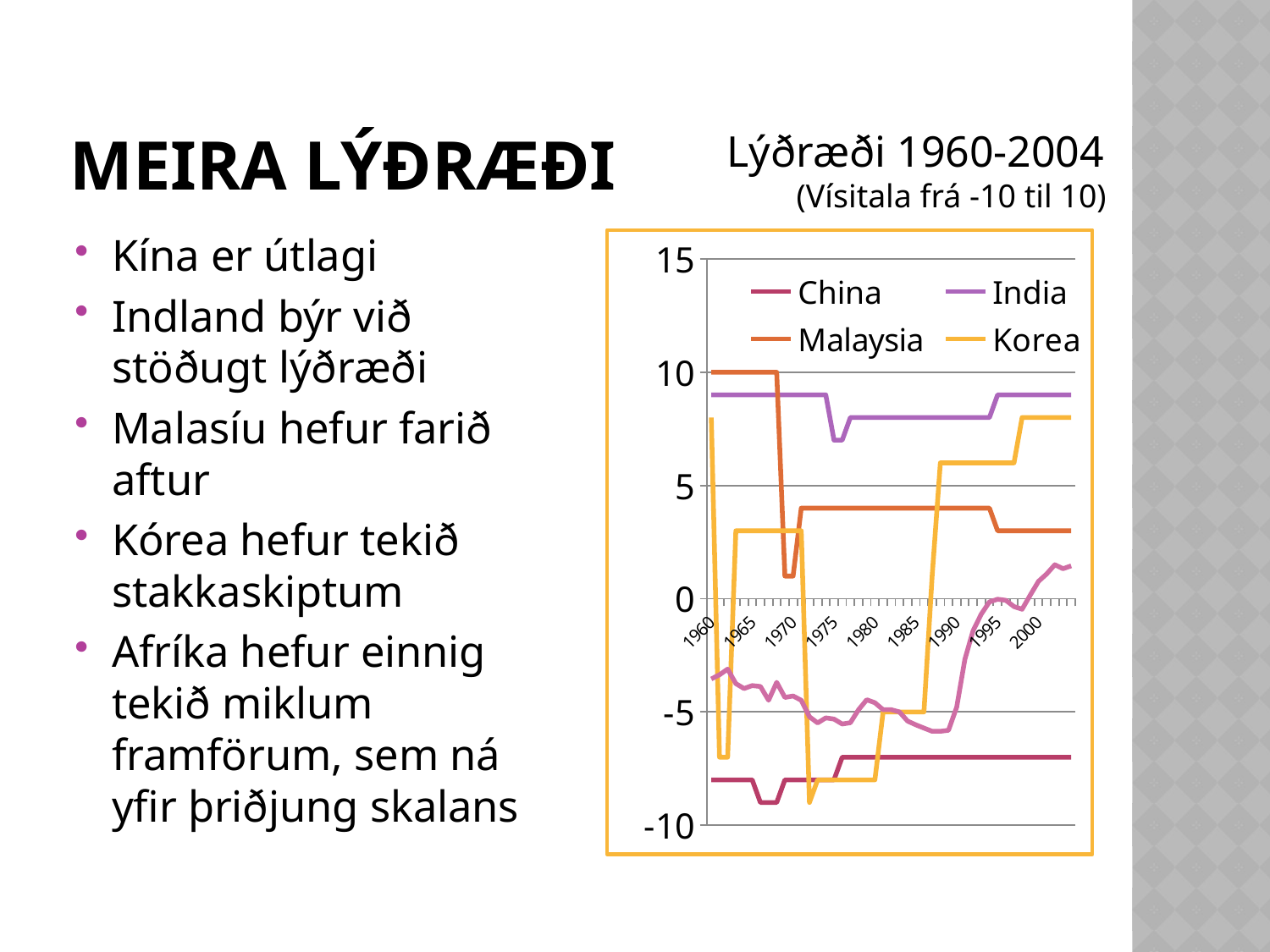
In 2000, which is higher, Korea or Malaysia? Korea What kind of chart is shown on the slide? line chart Which series has the lowest value in 2000? China Is the value for Malaysia in 2000 greater or less than 5? less Which series has the highest value in 1960? Malaysia Is the value for China in 1960 greater or less than -5? less How many series does the chart legend list? 4 Is the value for India in 1960 greater or less than 5? greater What is the value for Malaysia in 1960? 10 Does the Malaysia line rise or fall overall from 1960 to 2004? fall What is the title of the chart? Lýðræði 1960-2004 (Vísitala frá -10 til 10)